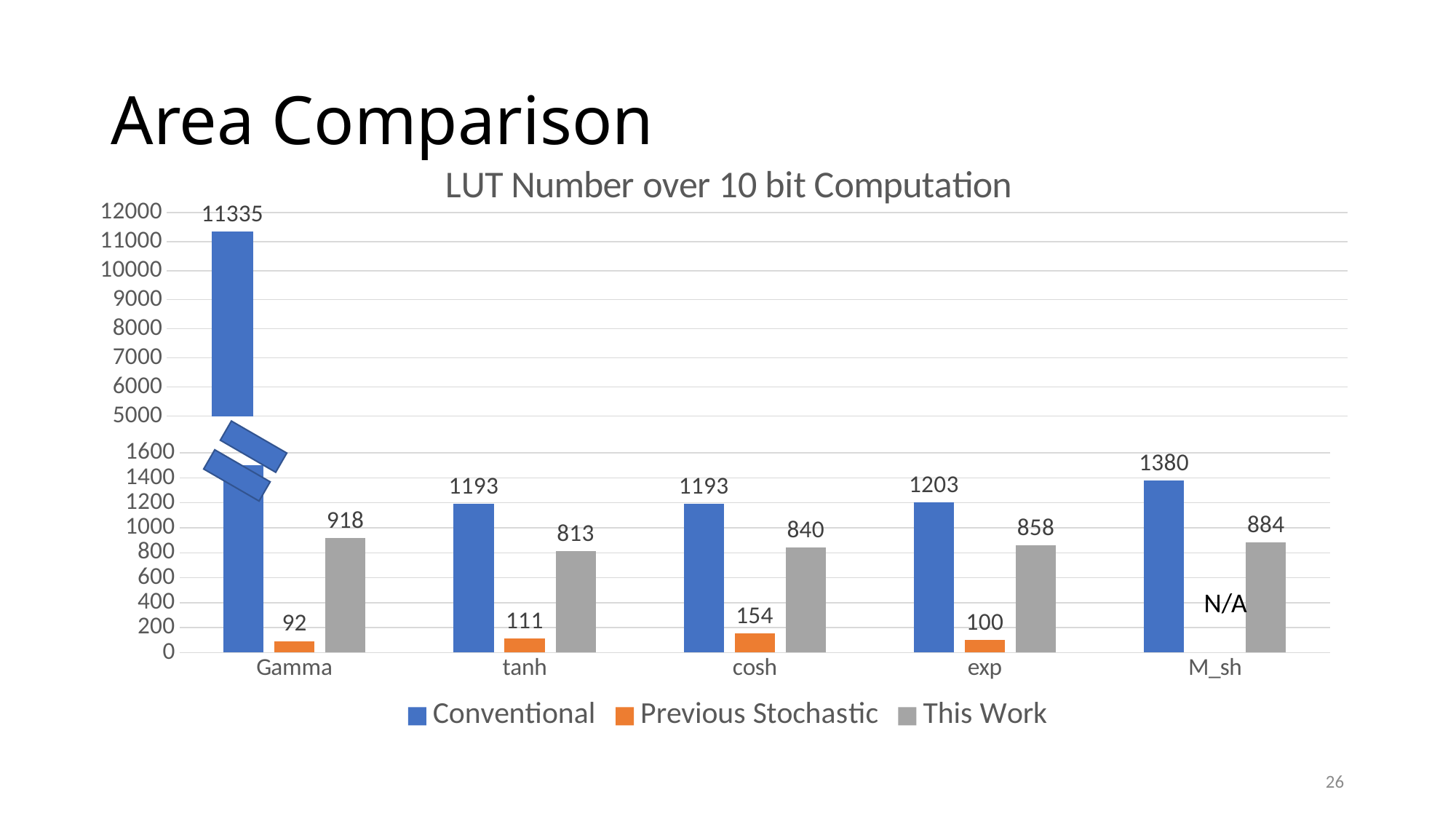
What is the title of the chart? LUT Number over 10 bit Computation Which category has the highest Conventional value? Gamma What kind of chart is shown? bar chart What is the difference between the Conventional and This Work values for exp? 345 Which category has the lowest Previous Stochastic value among those with a plotted value? Gamma What is the Conventional value for Gamma? 11335 How many categories are shown on the x axis? 5 What is the Previous Stochastic value for tanh? 111 What is the Conventional value for M_sh? 1380 Which is larger, the This Work value for Gamma or the This Work value for M_sh? Gamma What is the This Work value for cosh? 840 How many series does the legend list? 3